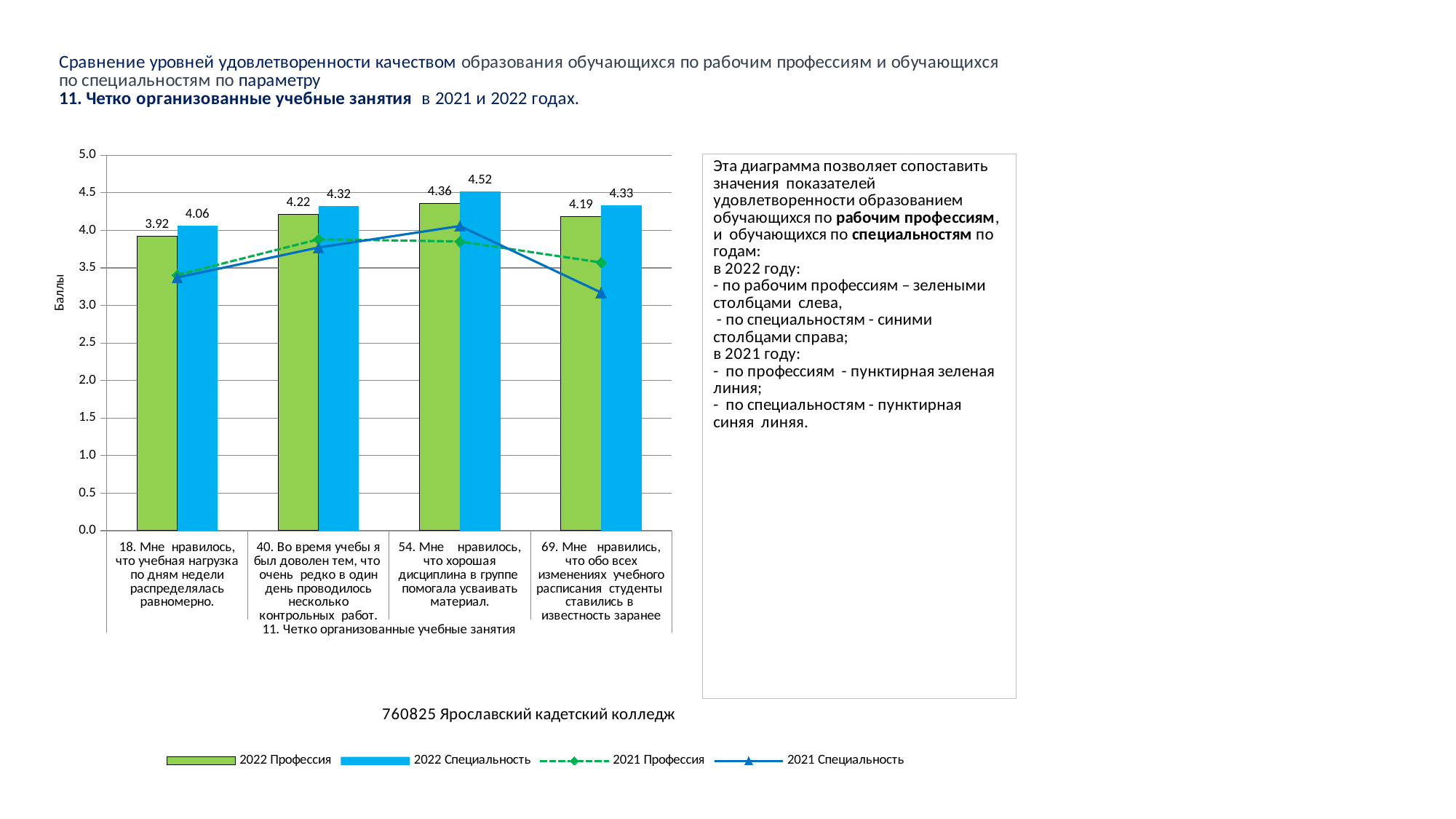
What is the label of the y axis? Баллы Is the 2021 Специальность line value for category 69 greater or less than 3.5? less What kind of chart is shown on the slide? Combined bar and line chart What is the difference between the 2022 Специальность and 2022 Профессия bars for category 40? 0.10 Which is larger for category 18: the 2022 Профессия bar or the 2022 Специальность bar? 2022 Специальность What is the value of the 2022 Специальность bar for category 54 (Мне нравилось, что хорошая дисциплина в группе помогала усваивать материал)? 4.52 Which category has the highest 2022 Профессия bar? 54. Мне нравилось, что хорошая дисциплина в группе помогала усваивать материал. What is the value of the 2022 Профессия bar for category 18 (Мне нравилось, что учебная нагрузка по дням недели распределялась равномерно)? 3.92 How many categories are shown on the x axis? 4 How many series does the legend list? 4 Which category has the lowest 2022 Специальность bar? 18. Мне нравилось, что учебная нагрузка по дням недели распределялась равномерно. What is the value of the 2022 Специальность bar for category 69 (Мне нравились, что обо всех изменениях учебного расписания студенты ставились в известность заранее)? 4.33